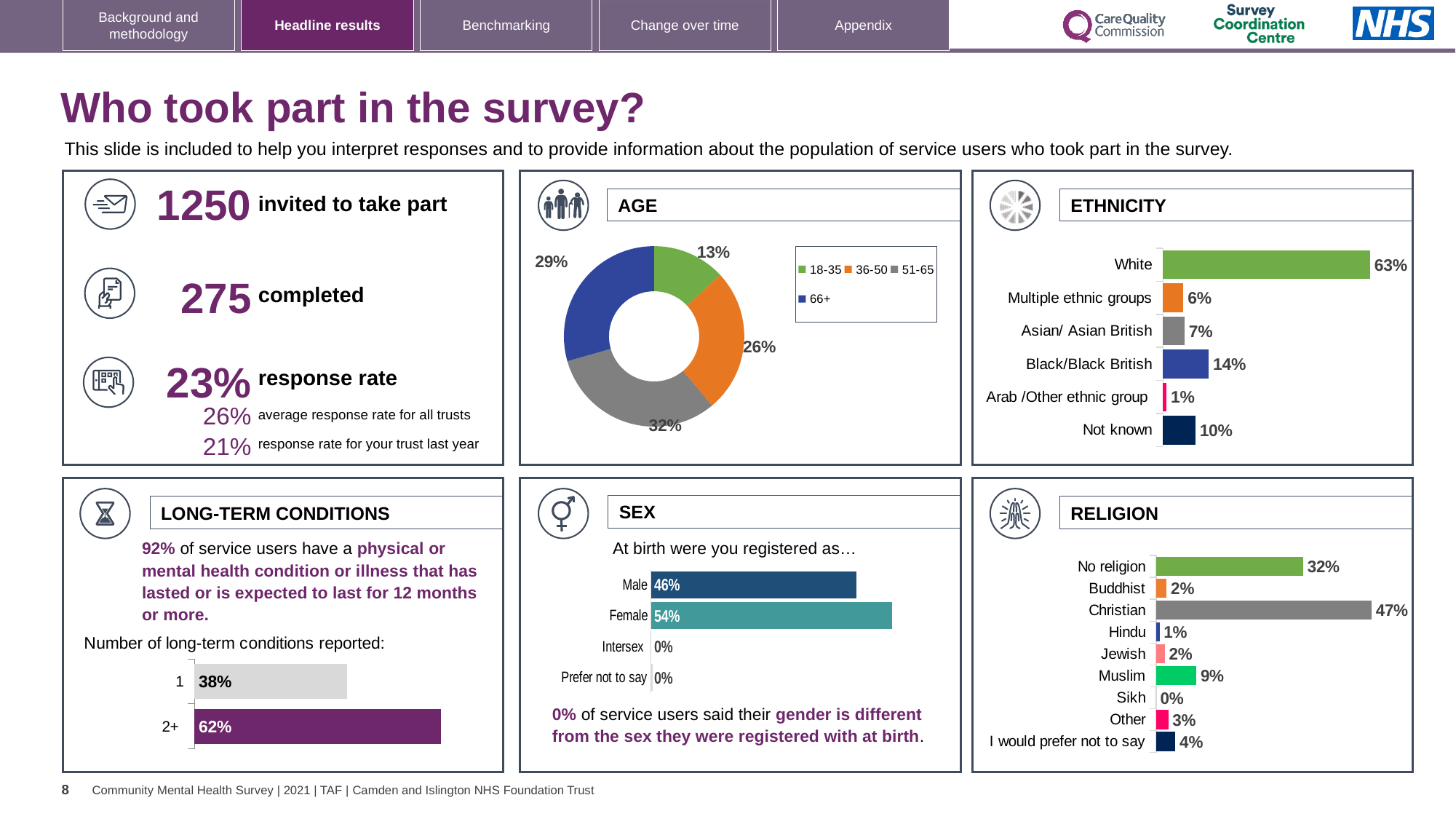
In the RELIGION chart, which category has the highest value? Christian In the ETHNICITY chart, what is the value for Black/Black British? 14% In the RELIGION chart, what is the value for Muslim? 9% In the LONG-TERM CONDITIONS chart, what percentage reported 2+ conditions? 62% In the AGE chart, what percentage of respondents are aged 51-65? 32% How many age groups does the legend of the AGE chart list? 4 In the ETHNICITY chart, which category has the highest value? White How many categories are shown in the ETHNICITY chart? 6 In the ETHNICITY chart, what is the difference between White and Not known? 53% In the SEX chart, which is larger, Male or Female? Female In the AGE chart, which age group has the smallest share? 18-35 What kind of chart is the AGE chart? Donut (pie) chart